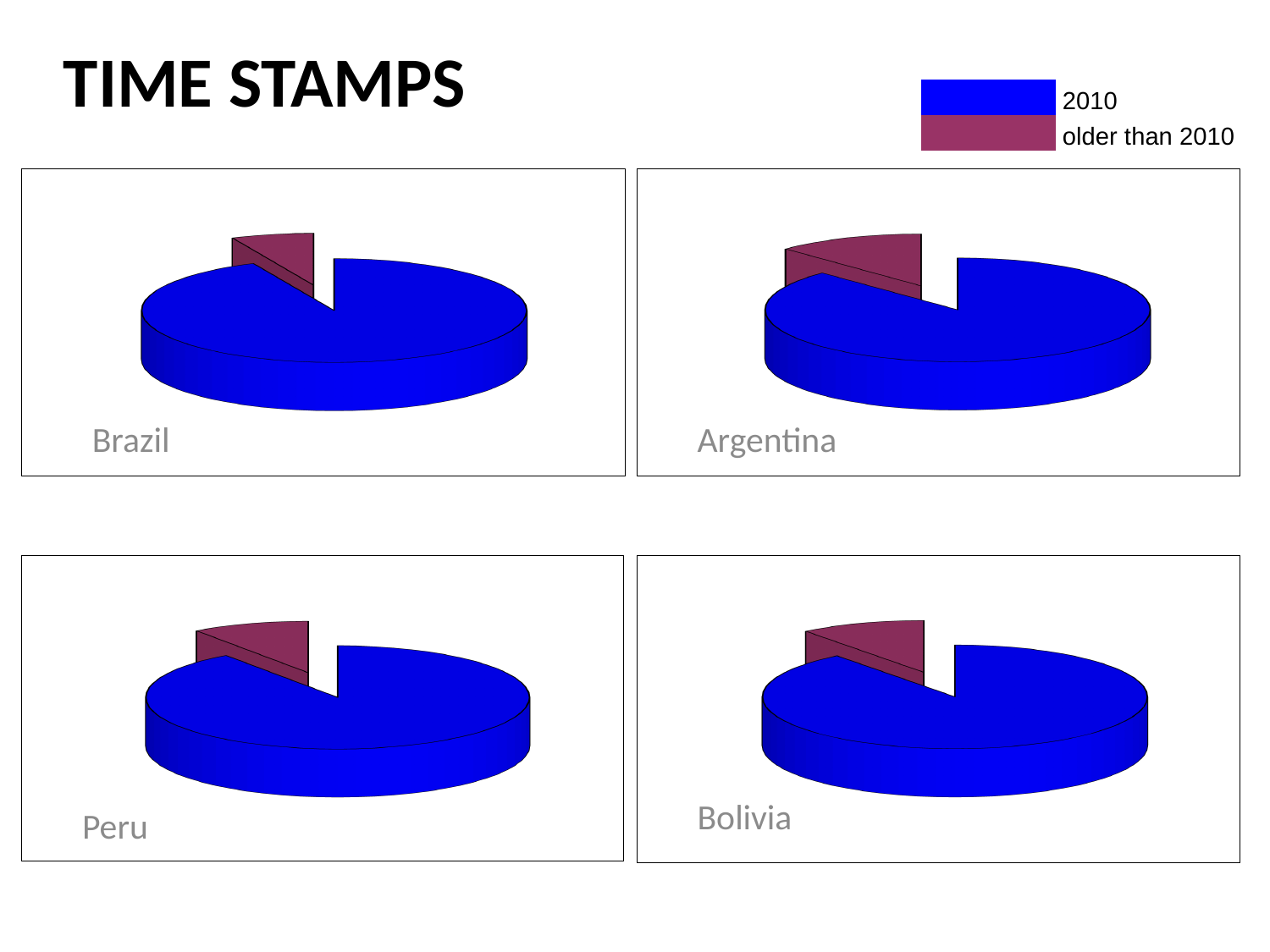
How many pie charts are shown on the slide? 4 Which colour represents the category 'older than 2010' in the legend? maroon In the Bolivia pie chart, which slice is larger: 2010 or older than 2010? 2010 What is the title of the slide? TIME STAMPS How many slices does the Peru pie chart have? 2 In the Peru pie chart, which category has the largest slice? 2010 Which country's pie chart is in the bottom-right position on the slide? Bolivia What kind of chart is used for Brazil? pie chart How many entries does the legend list? 2 In the Argentina pie chart, which category has the smallest slice? older than 2010 In the Brazil pie chart, which slice is larger: 2010 or older than 2010? 2010